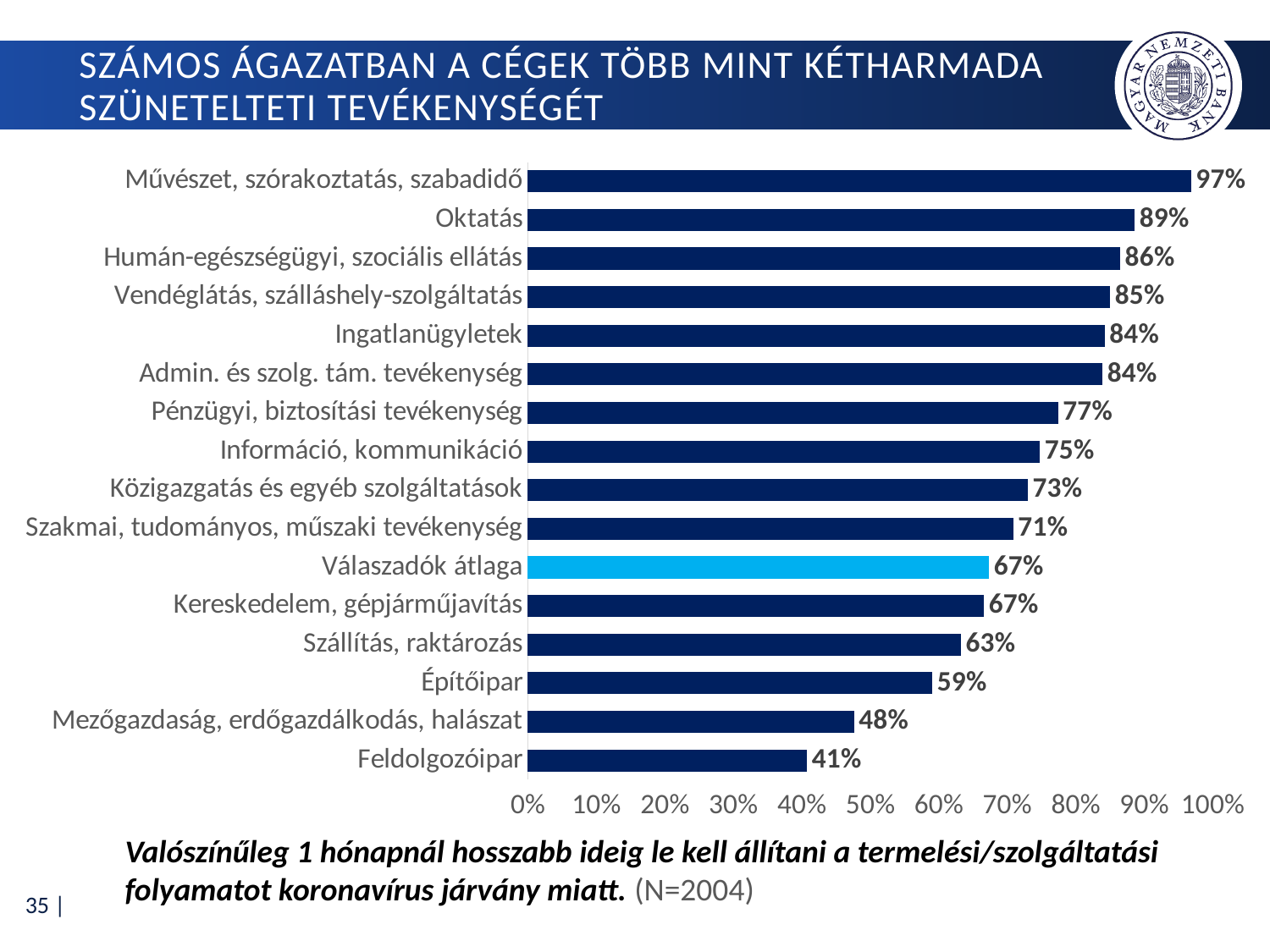
Which is larger, the value for Pénzügyi, biztosítási tevékenység or the value for Információ, kommunikáció? Pénzügyi, biztosítási tevékenység What is the difference between the values for Építőipar and Mezőgazdaság, erdőgazdálkodás, halászat? 11 percentage points Which category has the lowest value? Feldolgozóipar What kind of chart is shown on the slide? bar chart Is the value for Szállítás, raktározás greater or less than 50%? greater What is the value for Válaszadók átlaga? 67% Which bar is shown in a lighter blue colour than the others? Válaszadók átlaga What is the value for Oktatás? 89% What is the difference between the values for Művészet, szórakoztatás, szabadidő and Feldolgozóipar? 56 percentage points How many categories are shown in the chart? 16 Which category has the highest value? Művészet, szórakoztatás, szabadidő What is the value for Feldolgozóipar? 41%